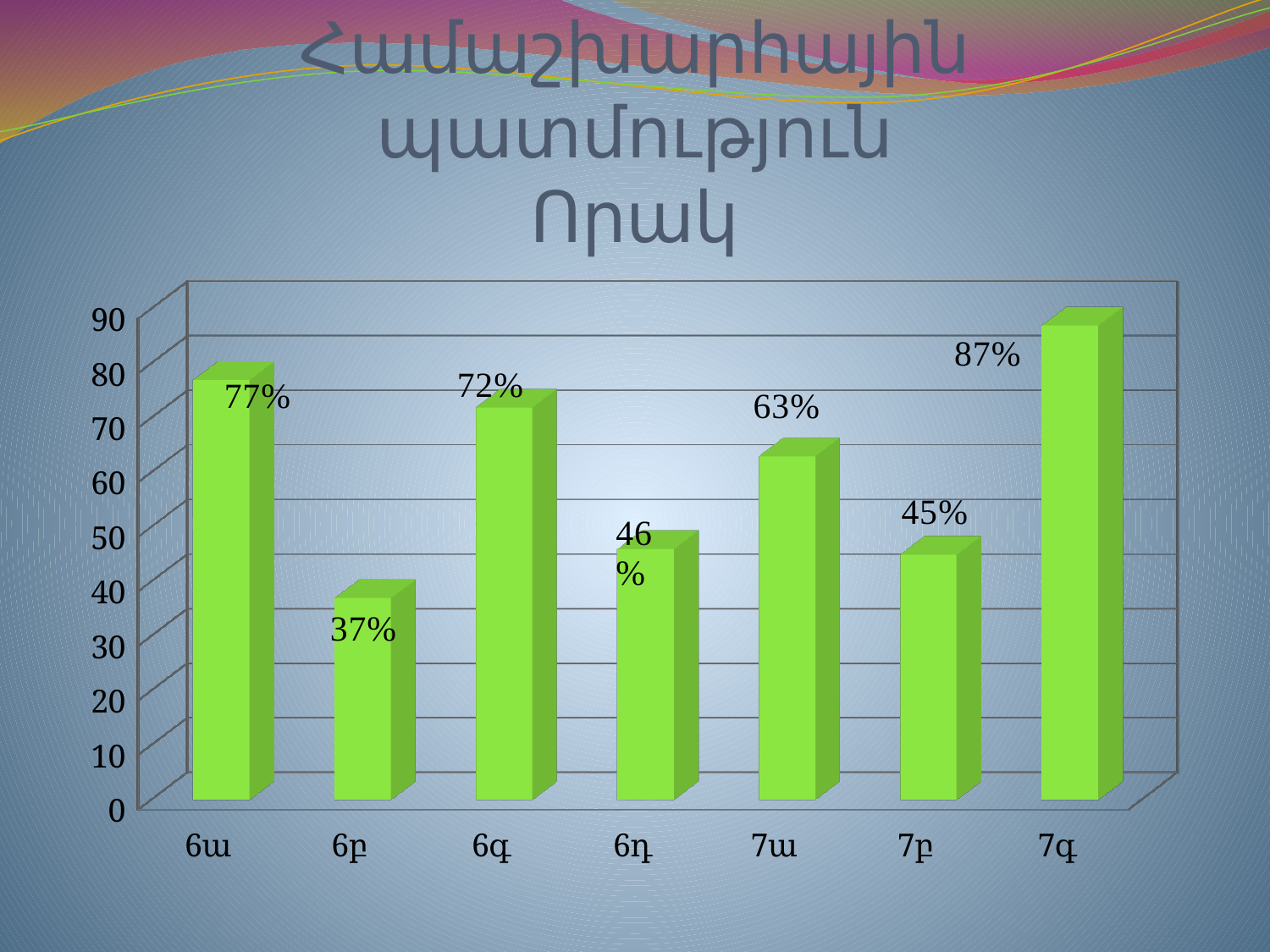
What is the difference between the values for 7գ and 6բ? 50% Which is larger, the value for 6դ or the value for 7բ? 6դ What is the value for 6ա? 77% How many categories are shown on the x axis? 7 What is the difference between the values for 6ա and 6գ? 5% Which category has the lowest value? 6բ What is the value for 6բ? 37% What is the value for 7ա? 63% Which category has the highest value? 7գ What kind of chart is shown on the slide? Bar chart What colour are the bars in the chart? Green What is the value for 7գ? 87%